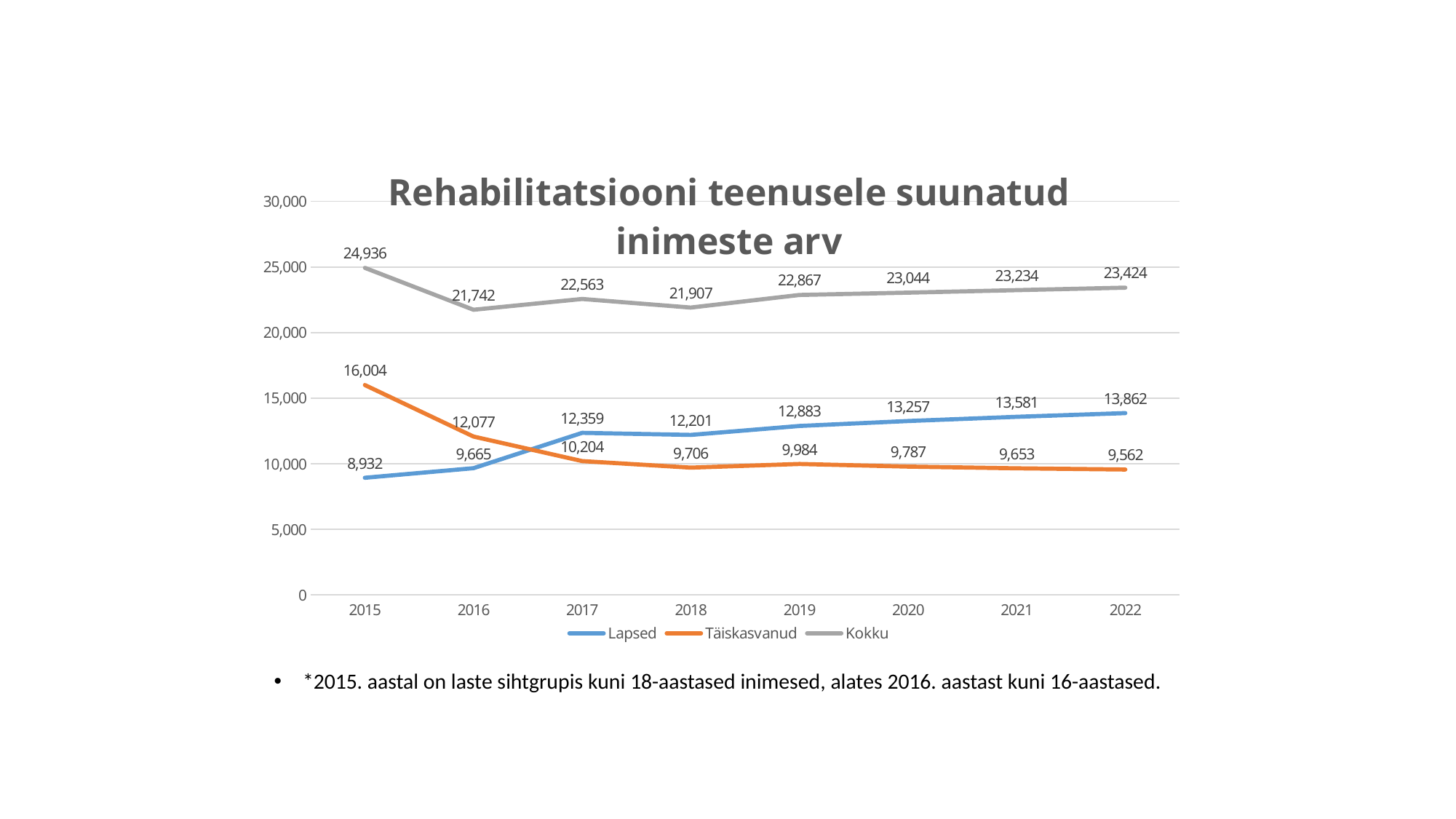
Does the Täiskasvanud series rise or fall from 2015 to 2022? fall What is the difference between the Lapsed and Täiskasvanud values in 2022? 4,300 Is the value for Kokku in 2016 greater or less than 20,000? greater Which is larger in 2016, Lapsed or Täiskasvanud? Täiskasvanud How many series does the legend list? 3 What is the value for Kokku in 2019? 22,867 How many years are shown on the x axis? 8 What is the value for Täiskasvanud in 2022? 9,562 What is the value for Lapsed in 2015? 8,932 What kind of chart is shown on the slide? line chart In which year is the Lapsed series lowest? 2015 In which year is the Kokku series highest? 2015